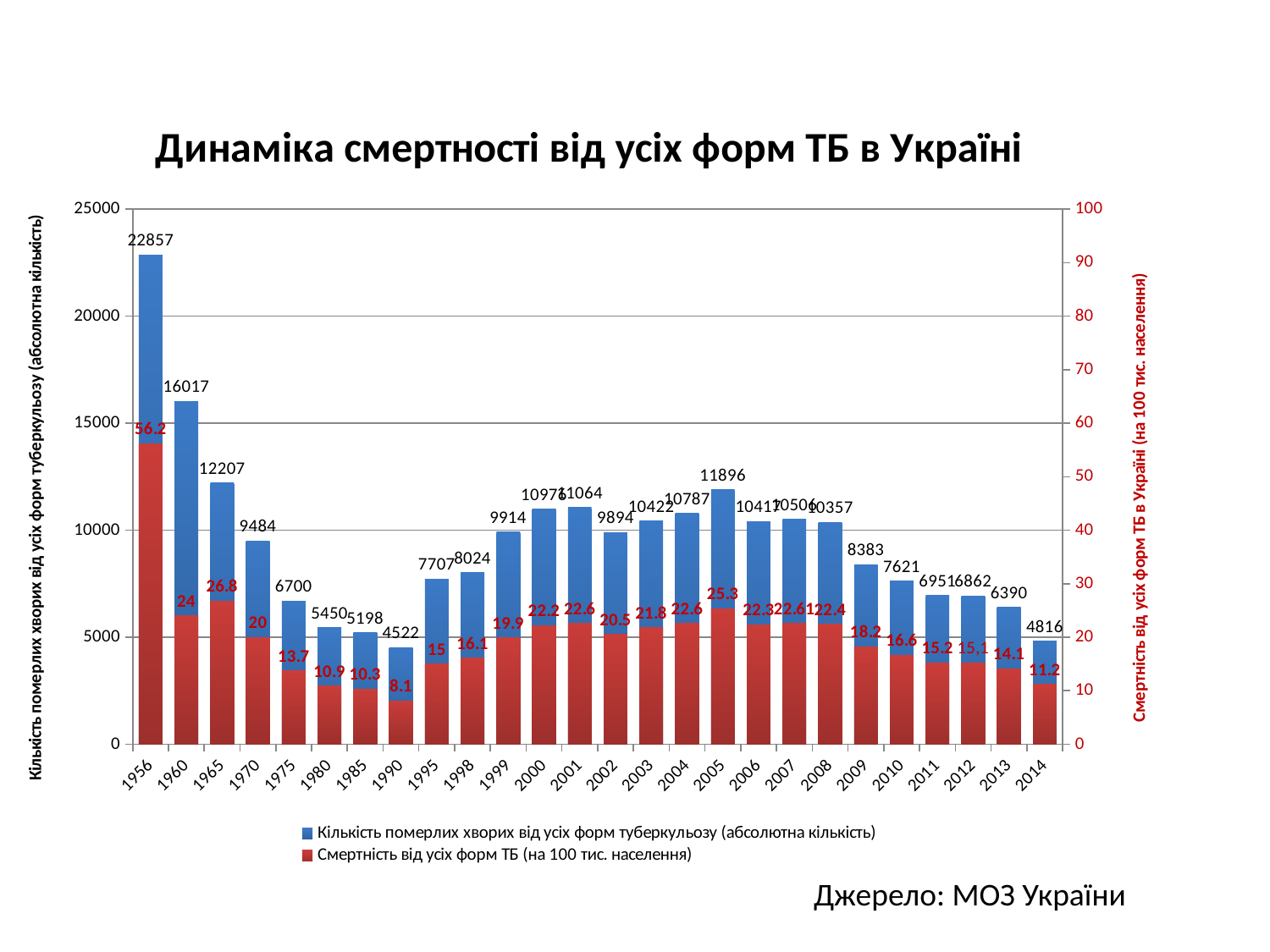
Which year has the highest mortality from all forms of TB per 100 thousand population? 1956 What is the difference in the absolute number of deaths from tuberculosis between 2005 and 2014? 7080 How many years are shown on the x axis of the chart? 26 What is the number of deaths from all forms of tuberculosis (absolute number) in 1956? 22857 Which year has the larger absolute number of deaths from tuberculosis, 2000 or 2001? 2001 What kind of chart is shown on the slide? bar chart Which year has the lowest absolute number of deaths from all forms of tuberculosis? 1990 What is the title of the chart? Динаміка смертності від усіх форм ТБ в Україні What is the absolute number of deaths from all forms of tuberculosis in 2014? 4816 How many series does the legend list? 2 Is the absolute number of deaths from tuberculosis in 1970 greater or less than 10000? less What is the mortality from all forms of TB per 100 thousand population in 2005? 25.3